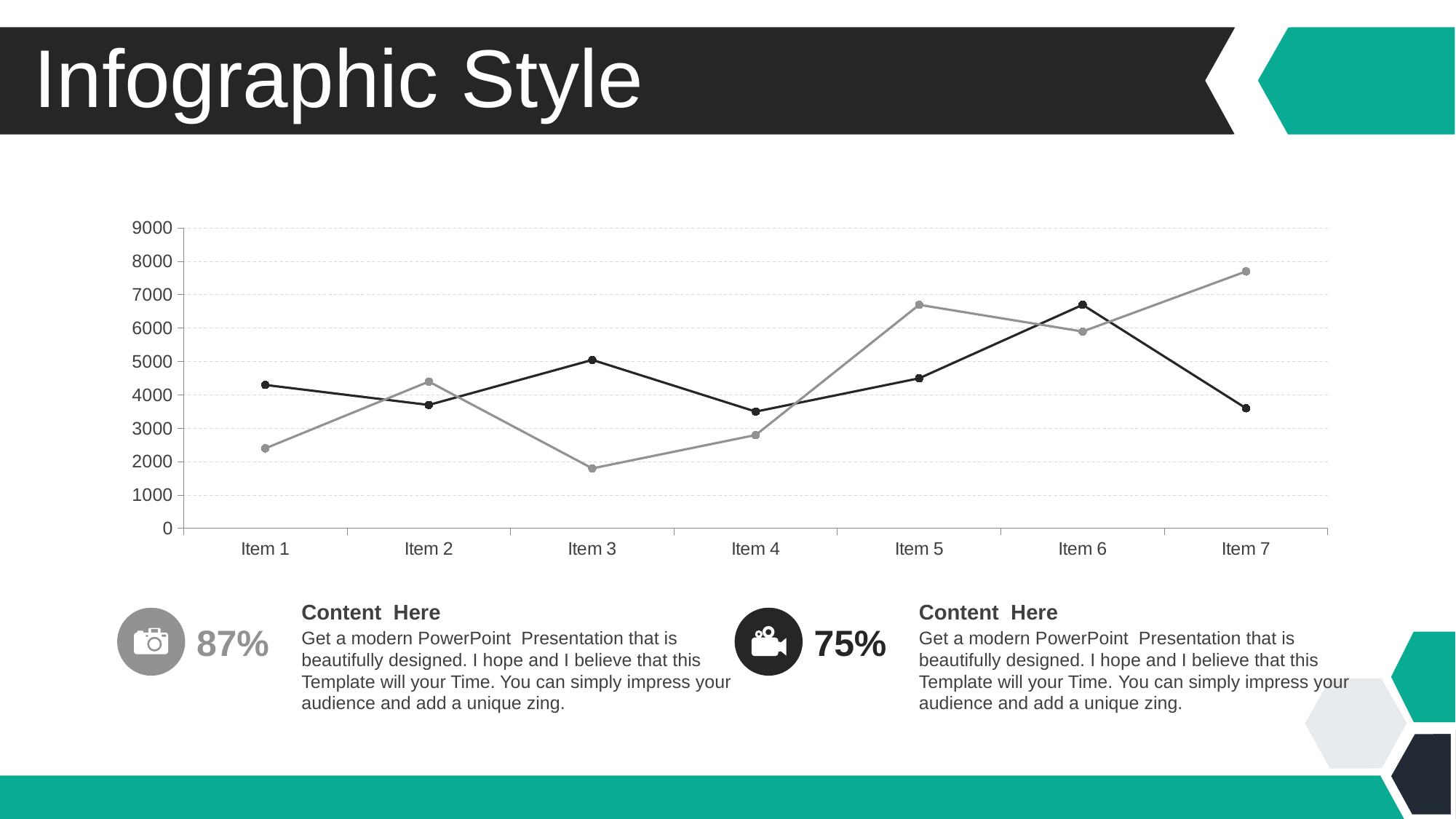
Is the value of the gray line at Item 7 greater or less than 7000? greater At which item does the black line reach its highest value? Item 6 At which item does the gray line reach its lowest value? Item 3 Is the value of the gray line at Item 3 greater or less than 2000? less Is the value of the black line at Item 6 greater or less than 6000? greater Does the gray line rise or fall from Item 3 to Item 7? rise What kind of chart is shown on the slide? line chart How many items are shown along the x axis of the chart? 7 How many lines are plotted on the chart? 2 At Item 3, which line has the higher value, the black line or the gray line? black line At which item does the gray line reach its highest value? Item 7